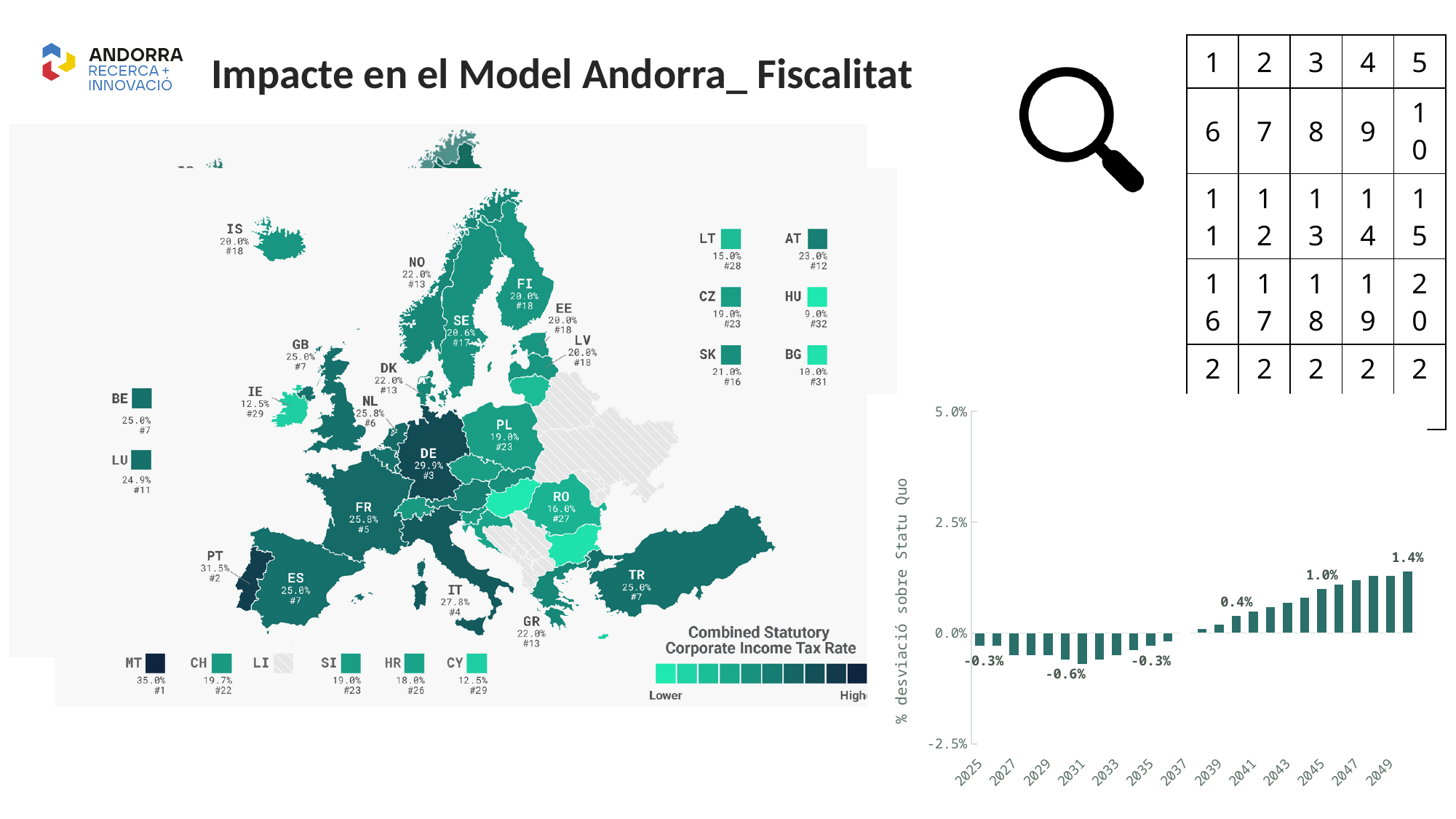
In the bar chart at the bottom right, what is the label on the vertical axis? % desviació sobre Statu Quo On the map of Europe, which country has the highest corporate income tax rate (ranked #1)? MT (35.0%) In the bar chart at the bottom right, what is the value labelled on the last bar (around 2049)? 1.4% On the map of Europe, which country has the lowest corporate income tax rate shown? HU (9.0%) In the bar chart at the bottom right, is the value for 2049 greater or less than 2.5%? less What kind of chart is shown at the bottom right of the slide? bar chart In the bar chart at the bottom right, what is the lowest labelled value? -0.6% In the bar chart at the bottom right, do the values generally rise or fall from 2031 to 2049? rise In the bar chart at the bottom right, what is the value labelled for the first bar (2025)? -0.3% In the bar chart at the bottom right, what is the difference between the last bar's value (1.4%) and the first bar's value (-0.3%)? 1.7 percentage points On the map of Europe, what combined statutory corporate income tax rate is shown for Germany (DE)? 29.9% In the bar chart at the bottom right, what is the highest labelled value? 1.4%